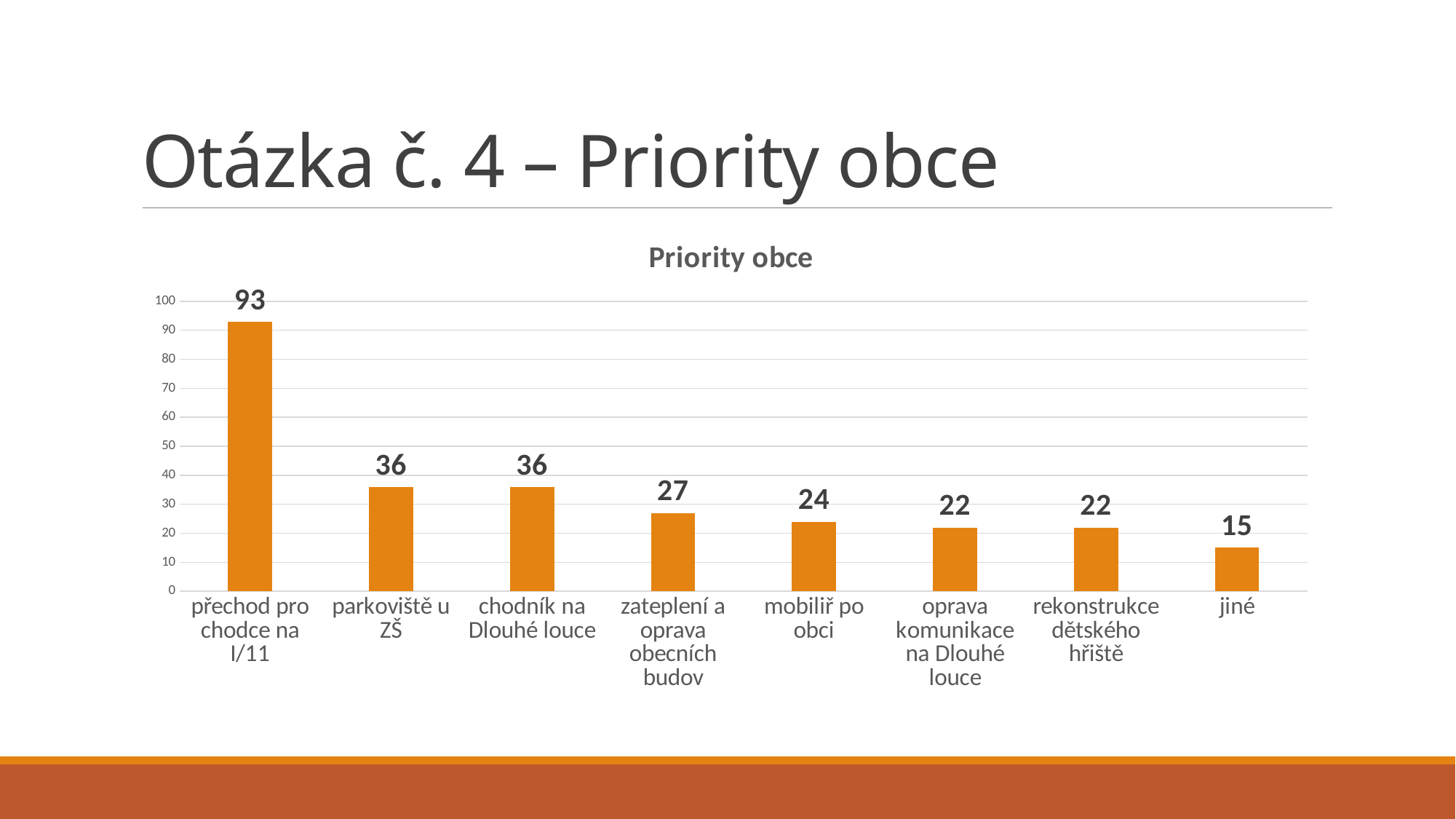
What is the difference between the values for "zateplení a oprava obecních budov" and "jiné"? 12 What is the title of the chart? Priority obce How many categories are shown on the x axis? 8 Which category has the highest value? přechod pro chodce na I/11 What kind of chart is shown on the slide? bar chart What is the value for "jiné"? 15 What is the value for "zateplení a oprava obecních budov"? 27 What is the value for "mobiliř po obci"? 24 Which category has the lowest value? jiné Which is larger, the value for "mobiliř po obci" or the value for "rekonstrukce dětského hřiště"? mobiliř po obci What is the difference between the values for "přechod pro chodce na I/11" and "parkoviště u ZŠ"? 57 What is the value for "přechod pro chodce na I/11"? 93